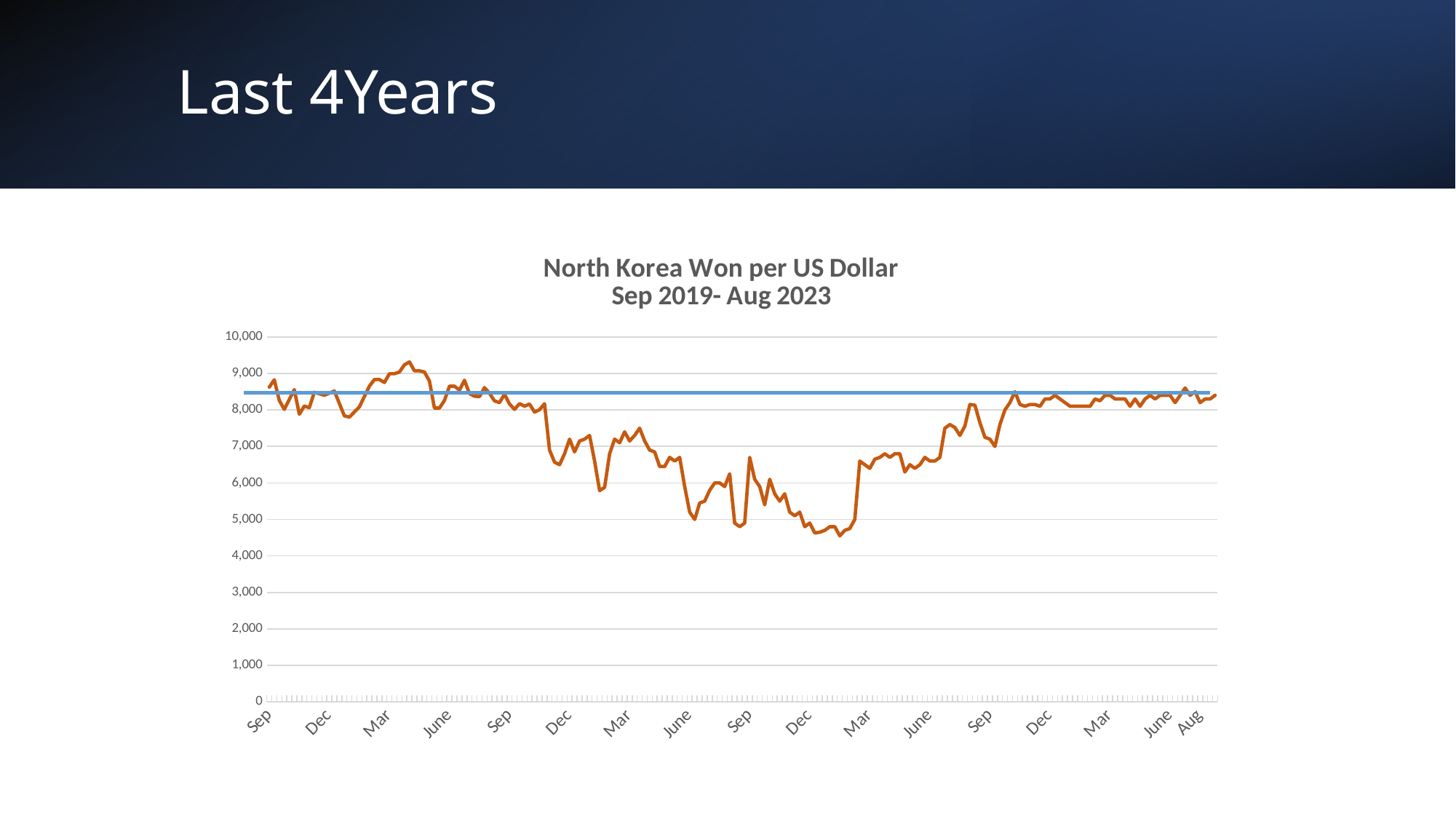
What is the highest value shown on the vertical axis of the chart? 10,000 How many month labels are shown along the x axis of the chart? 17 Is the value of the orange line at the first Sep label greater or less than 8,000? greater What kind of chart is shown on the slide? line chart Is the orange line's value at the first Mar label higher or lower than its value at the third Mar label? higher Is the highest point of the orange line greater or less than 9,000? greater Is the horizontal blue line above or below 8,000 on the vertical axis? above What is the title of the chart? North Korea Won per US Dollar Sep 2019- Aug 2023 Does the orange line generally rise or fall between the third Dec label and the fourth Sep label? rise Does the orange line generally rise or fall between the second June label and the third Dec label? fall